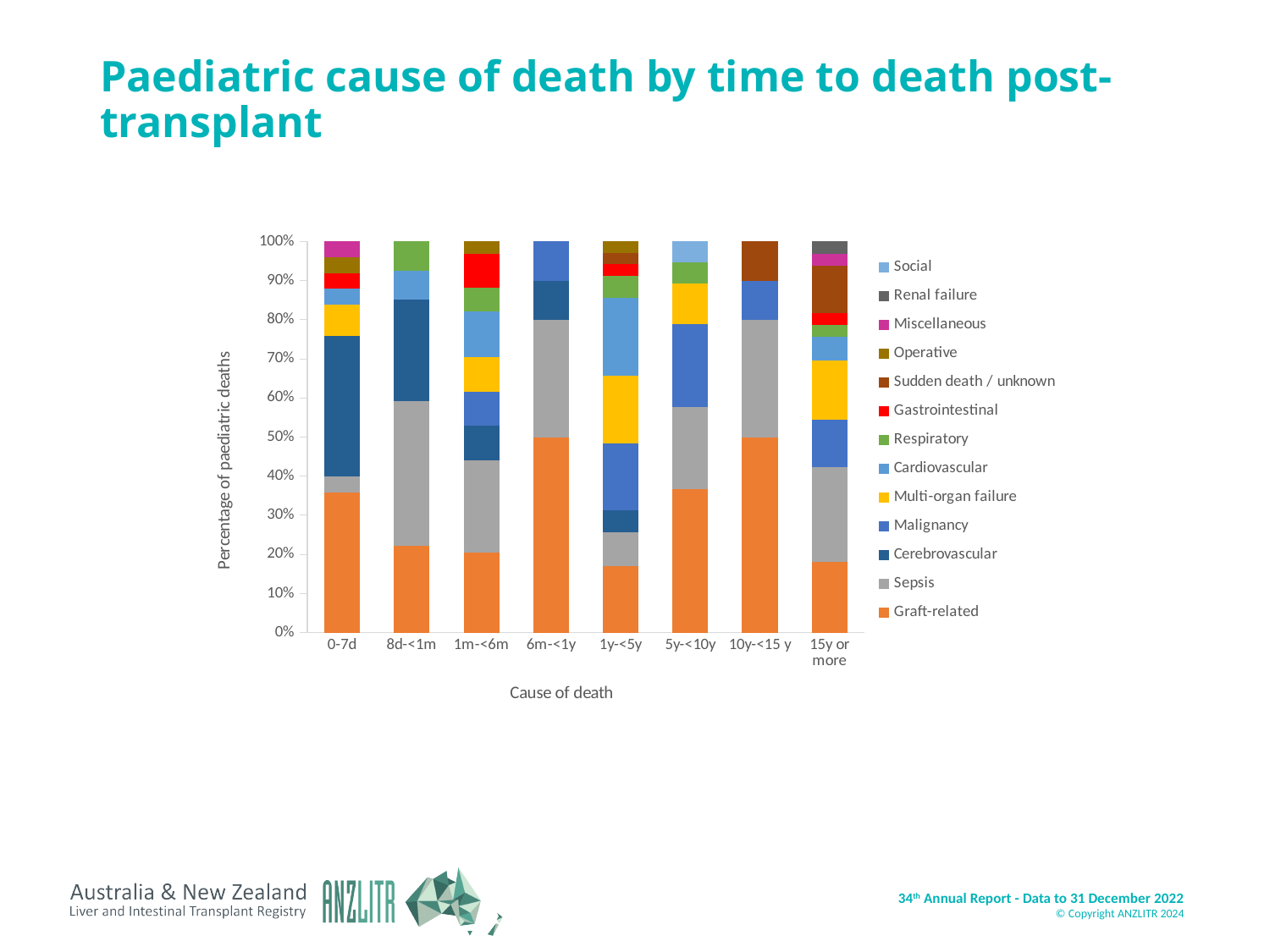
What is the label on the y axis? Percentage of paediatric deaths What type of chart is shown on the slide? Stacked bar chart Which cause of death is shown in orange at the bottom of each bar? Graft-related Is the Graft-related share for the 0-7d category greater or less than 30%? greater How many causes of death does the legend list? 13 What does each stacked bar total? 100% Which category has the larger Graft-related share, 6m-<1y or 1y-<5y? 6m-<1y Is the Graft-related share for the 6m-<1y category greater or less than 40%? greater Is the Graft-related share for the 1y-<5y category greater or less than 20%? less Which category has the larger Graft-related share, 0-7d or 8d-<1m? 0-7d How many time-to-death categories are shown on the x axis? 8